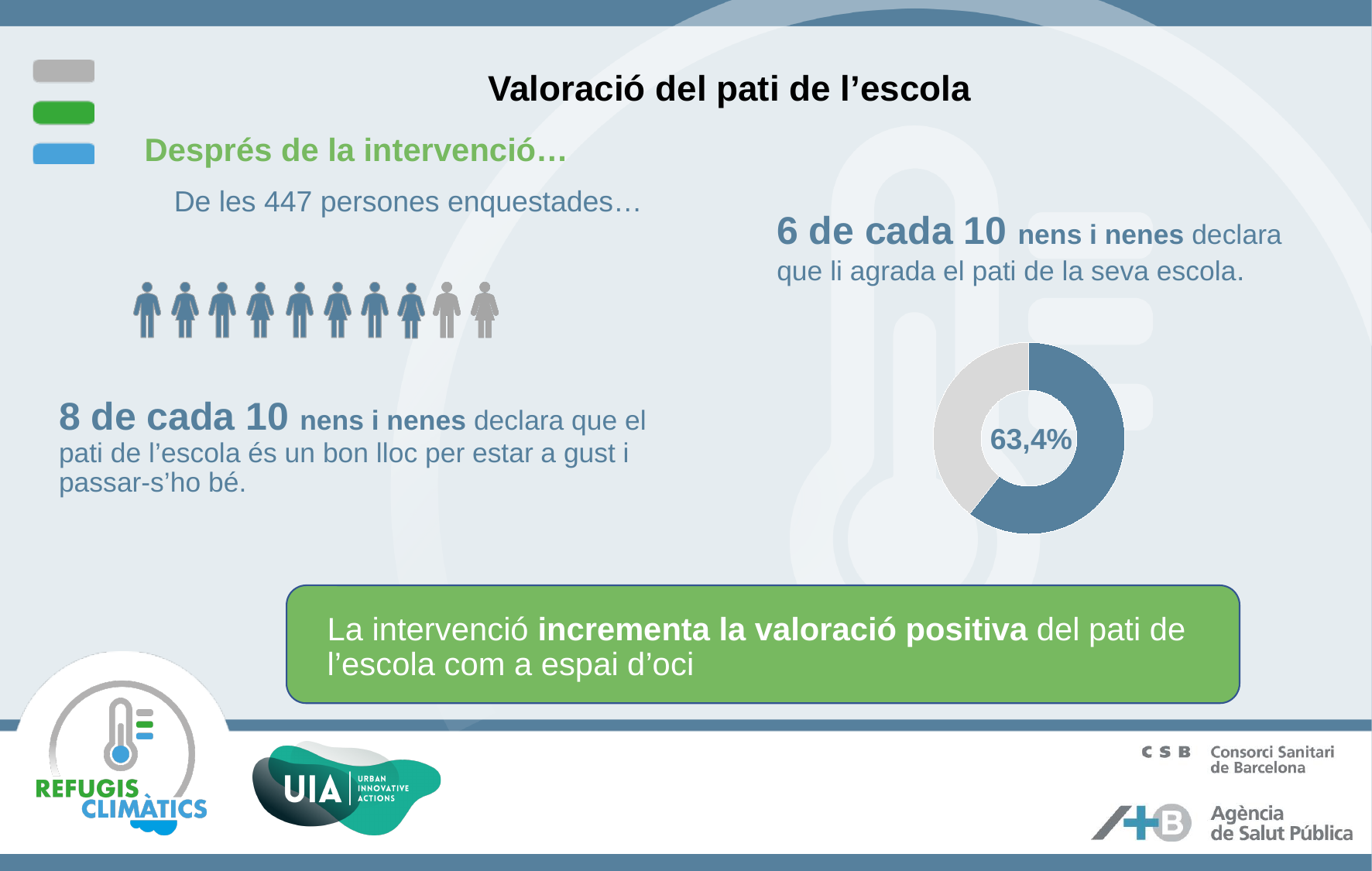
What is the title of the slide? Valoració del pati de l'escola How many slices does the donut chart have? 2 How many of the person icons in the pictogram are coloured blue? 8 According to the text above the donut chart, how many out of every 10 children say they like their school playground? 6 de cada 10 What kind of chart is shown on the right side of the slide? Donut (pie) chart What percentage is printed in the centre of the donut chart? 63,4% What share of the donut chart does the blue slice represent? 63,4% In the donut chart, which slice is larger, the blue one or the grey one? The blue one Is the blue slice of the donut chart greater or less than 50%? greater According to the text next to the pictogram, how many out of every 10 children say the school playground is a good place to be comfortable and have fun? 8 de cada 10 How many of the person icons in the pictogram are coloured grey? 2